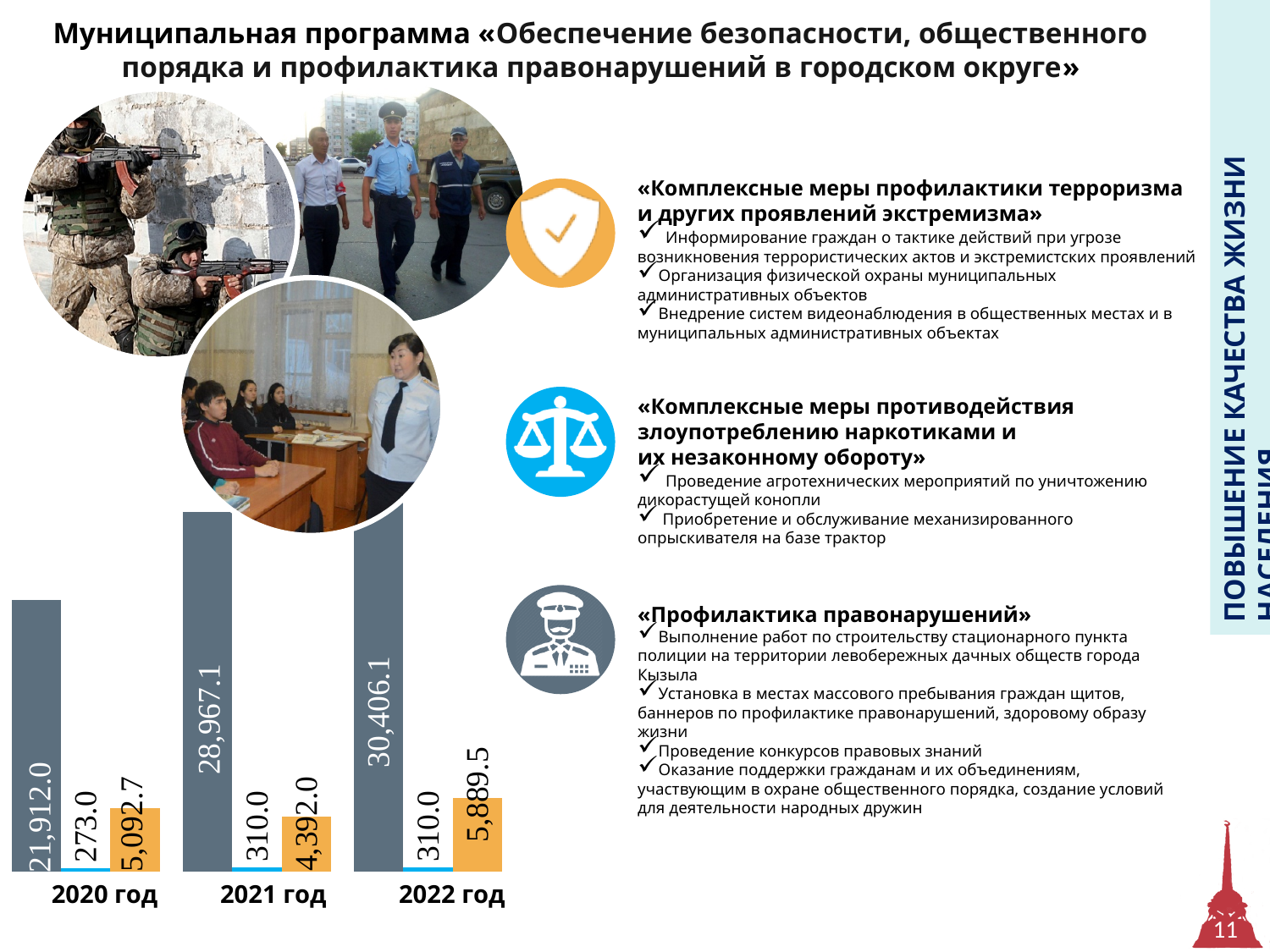
Do the gray bar values rise or fall from 2020 год to 2022 год? rise Which is larger: the orange bar for 2020 год or the orange bar for 2022 год? 2022 год (5,889.5) How many year categories are shown on the x axis of the chart? 3 What is the value of the tallest (gray) bar for 2020 год? 21,912.0 What is the value of the orange bar for 2021 год? 4,392.0 In which year is the orange bar the lowest? 2021 год What is the value of the tallest (gray) bar for 2022 год? 30,406.1 How many bars are shown for each year in the chart? 3 In which year is the gray bar the highest? 2022 год What is the difference between the gray bar values for 2022 год and 2021 год? 1,439.0 What is the value of the blue bar for 2020 год? 273.0 What type of chart is shown on the slide? bar chart